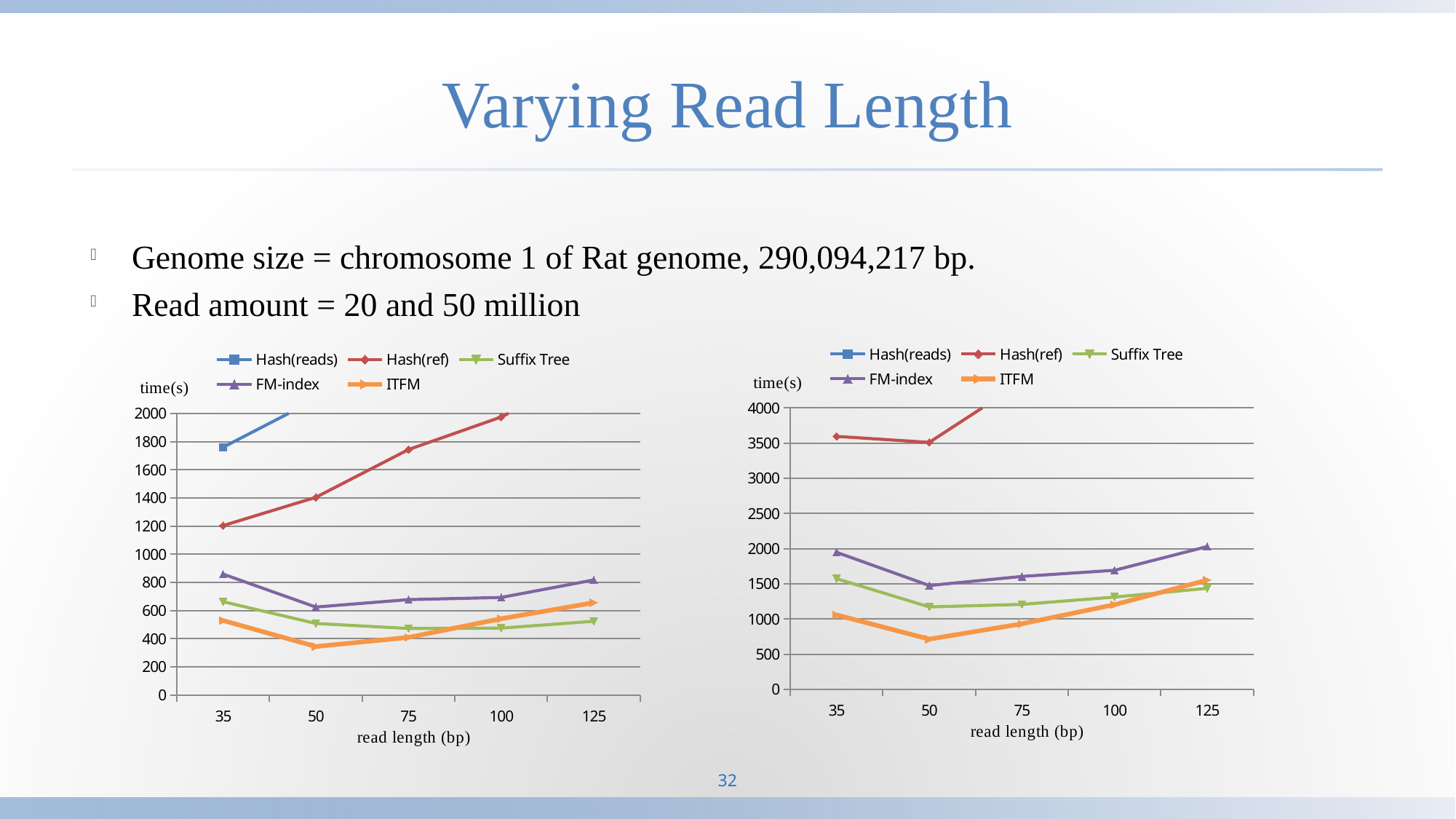
In the left chart, at which read length does ITFM reach its lowest value? 50 In the right chart, at read length 125, which is larger: FM-index or ITFM? FM-index In the right chart, is the value for Hash(ref) at read length 35 greater or less than 3500? greater In the left chart, at read length 35, which is larger: Hash(ref) or FM-index? Hash(ref) In the left chart, is the value for ITFM at read length 50 greater or less than 400? less What is the x axis label of the right chart? read length (bp) In the right chart, is the value for ITFM at read length 50 greater or less than 1000? less How many read length values are shown on the x axis of the left chart? 5 How many series does the legend of the right chart list? 5 What kind of chart is the left chart on the slide? line chart In the left chart, does the Hash(ref) line rise or fall from read length 35 to 100? rise